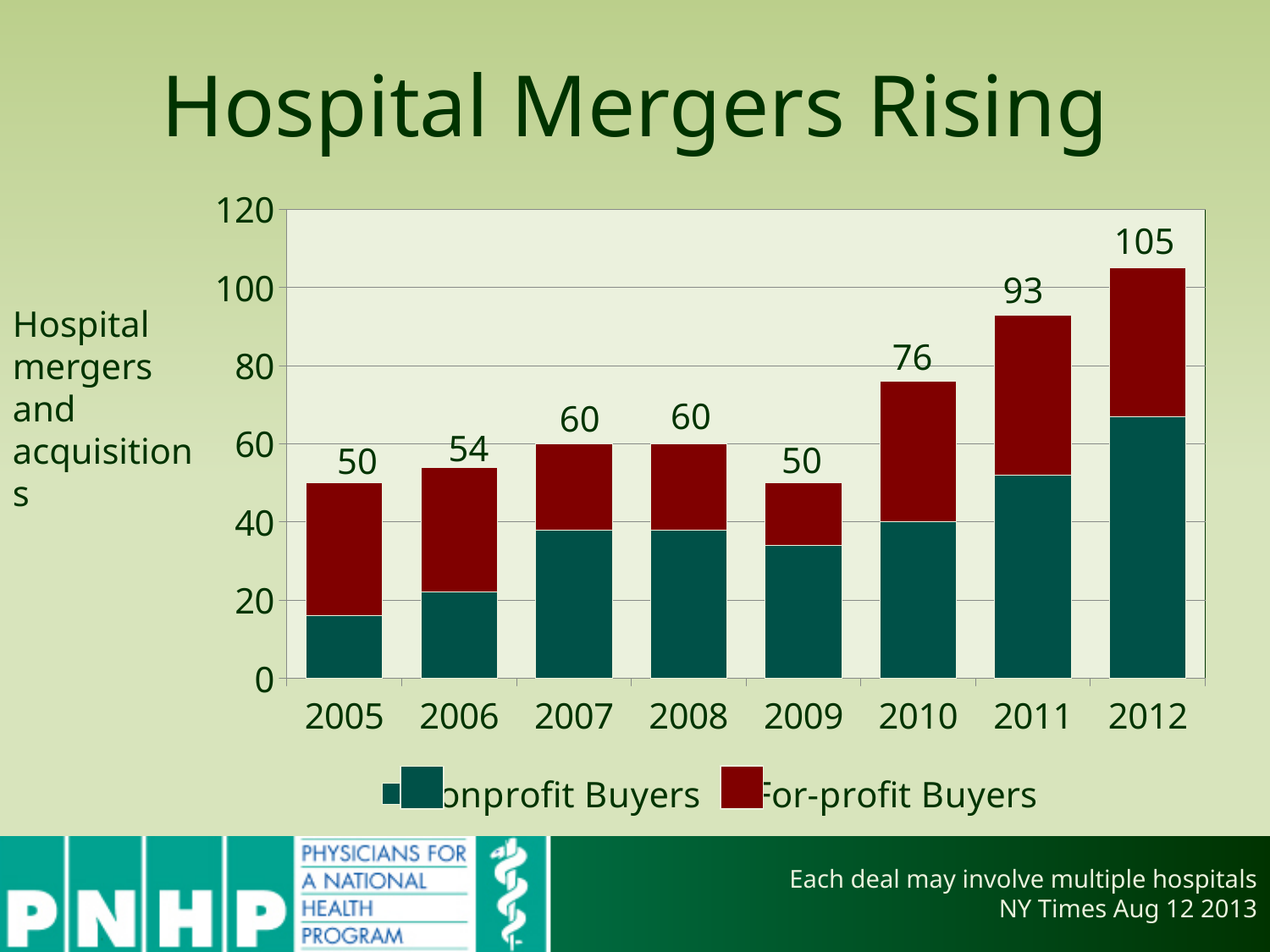
What is the total number of hospital mergers and acquisitions shown for 2012? 105 What is the total value labeled on the bar for 2006? 54 How many years are shown on the x axis of the chart? 8 Which year has the highest total of hospital mergers and acquisitions? 2012 Which year has a larger total, 2009 or 2010? 2010 Is the value for Nonprofit Buyers in 2005 greater or less than 20? less What is the lowest total value labeled on any bar in the chart? 50 What kind of chart is shown on the slide? Stacked bar chart Is the value for Nonprofit Buyers in 2012 greater or less than 60? greater What is the total value labeled on the bar for 2010? 76 How many series does the legend list? 2 What is the difference between the total for 2012 and the total for 2011? 12